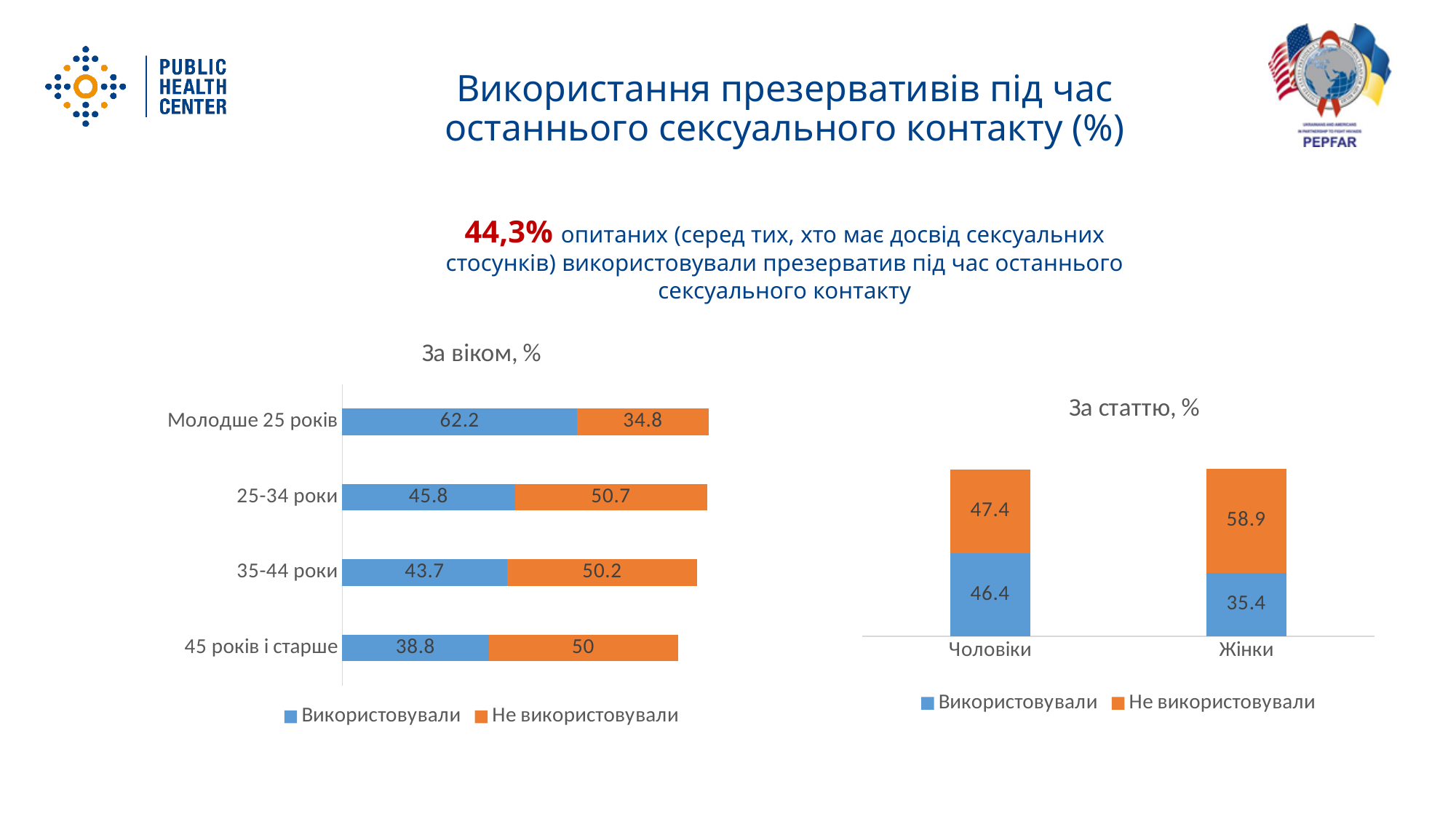
What kind of chart is the 'За віком, %' chart? Stacked bar chart In the 'За статтю, %' chart, what is the difference between the 'Не використовували' values for 'Жінки' and 'Чоловіки'? 11.5 In the 'За віком, %' chart, which age group has the lowest 'Використовували' value? 45 років і старше In the 'За віком, %' chart, what is the 'Використовували' value for 'Молодше 25 років'? 62.2 In the 'За статтю, %' chart, which group has the larger 'Використовували' value, 'Чоловіки' or 'Жінки'? Чоловіки In the 'За віком, %' chart, what is the total of the stacked bar for '35-44 роки'? 93.9 In the 'За віком, %' chart, which age group has the highest 'Використовували' value? Молодше 25 років In the 'За віком, %' chart, what is the difference between the 'Використовували' values for 'Молодше 25 років' and '45 років і старше'? 23.4 In the 'За статтю, %' chart, what is the 'Не використовували' value for 'Жінки'? 58.9 In the 'За віком, %' chart, how many age groups are shown? 4 How many series does the legend of the 'За статтю, %' chart list? 2 In the 'За віком, %' chart, what is the 'Не використовували' value for '25-34 роки'? 50.7